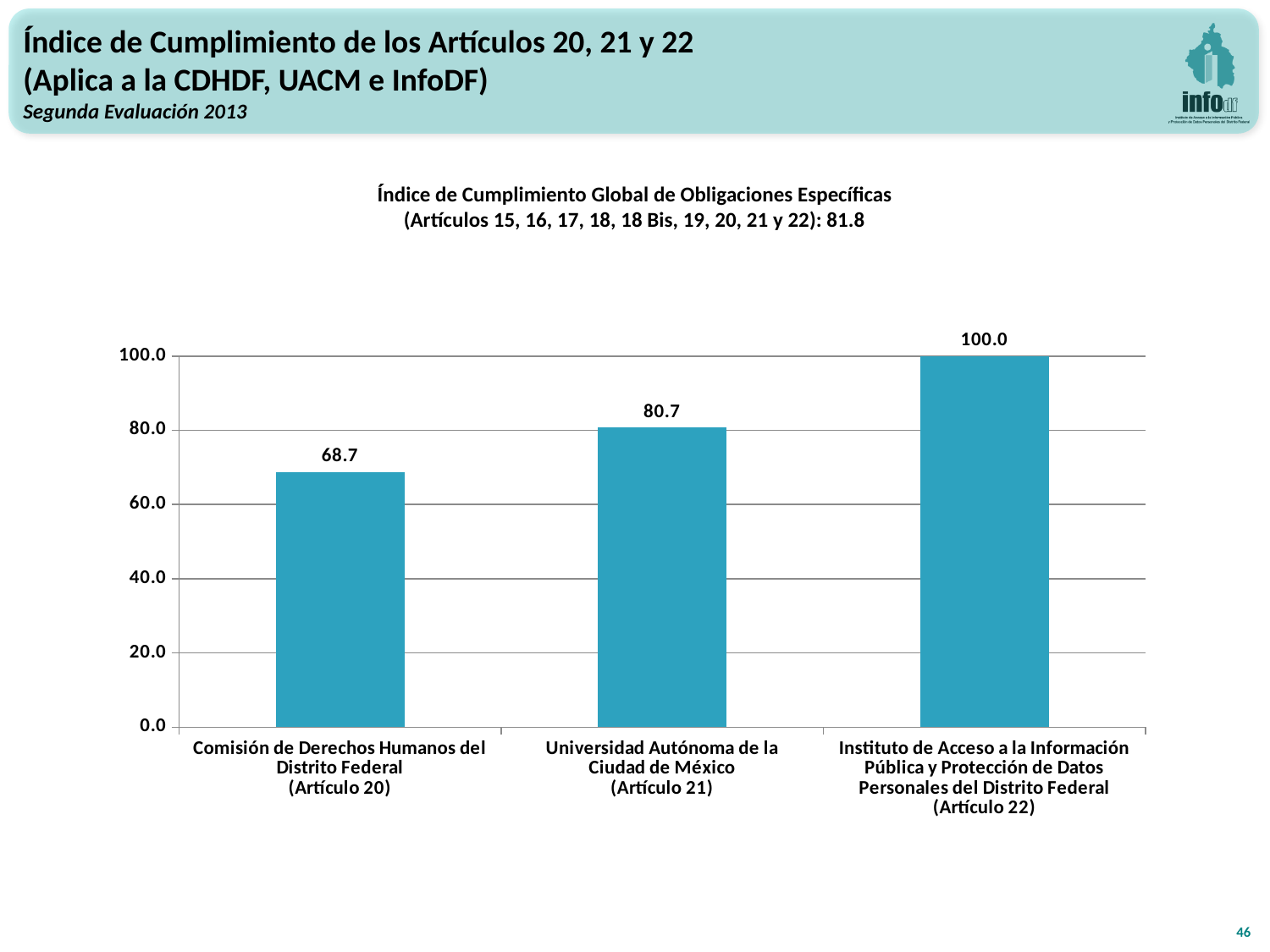
Which is larger, the value for Universidad Autónoma de la Ciudad de México (Artículo 21) or Comisión de Derechos Humanos del Distrito Federal (Artículo 20)? Universidad Autónoma de la Ciudad de México (Artículo 21) Is the value for Comisión de Derechos Humanos del Distrito Federal (Artículo 20) greater or less than 60.0? greater Which category has the highest value? Instituto de Acceso a la Información Pública y Protección de Datos Personales del Distrito Federal (Artículo 22) What kind of chart is shown on the slide? Bar chart What is the value for Universidad Autónoma de la Ciudad de México (Artículo 21)? 80.7 What is the difference between the values for Artículo 22 and Artículo 20? 31.3 What is the value for Instituto de Acceso a la Información Pública y Protección de Datos Personales del Distrito Federal (Artículo 22)? 100.0 Which category has the lowest value? Comisión de Derechos Humanos del Distrito Federal (Artículo 20) Do the values rise or fall from left to right across the categories? Rise What is the value for Comisión de Derechos Humanos del Distrito Federal (Artículo 20)? 68.7 How many categories are shown in the chart? 3 What is the difference between the values for Artículo 21 and Artículo 20? 12.0